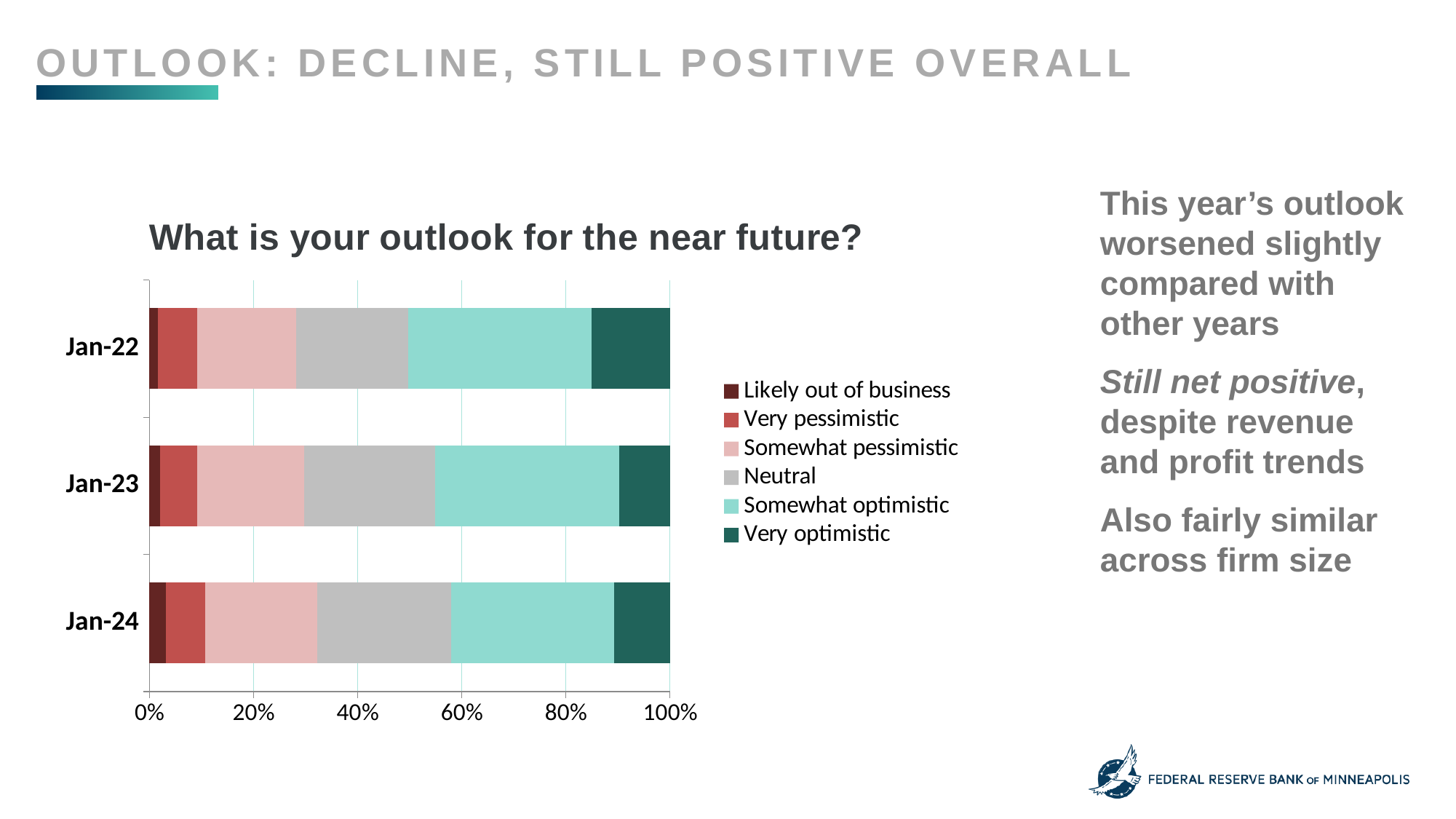
What is the title of the chart? What is your outlook for the near future? Is the combined share of the three pessimistic responses (Likely out of business, Very pessimistic, Somewhat pessimistic) for Jan-24 greater or less than 40%? less Is the 'Very optimistic' share larger for Jan-22 or for Jan-24? Jan-22 How many series does the legend list? 6 Which year has the largest 'Likely out of business' share? Jan-24 Which year has the largest 'Very optimistic' share? Jan-22 What kind of chart is shown on the slide? Stacked bar chart How many survey years (categories) are plotted on the chart? 3 Is the 'Somewhat optimistic' share for Jan-22 greater or less than 20%? greater Which response option is listed first in the legend? Likely out of business Is the 'Neutral' share for Jan-24 greater or less than 20%? greater